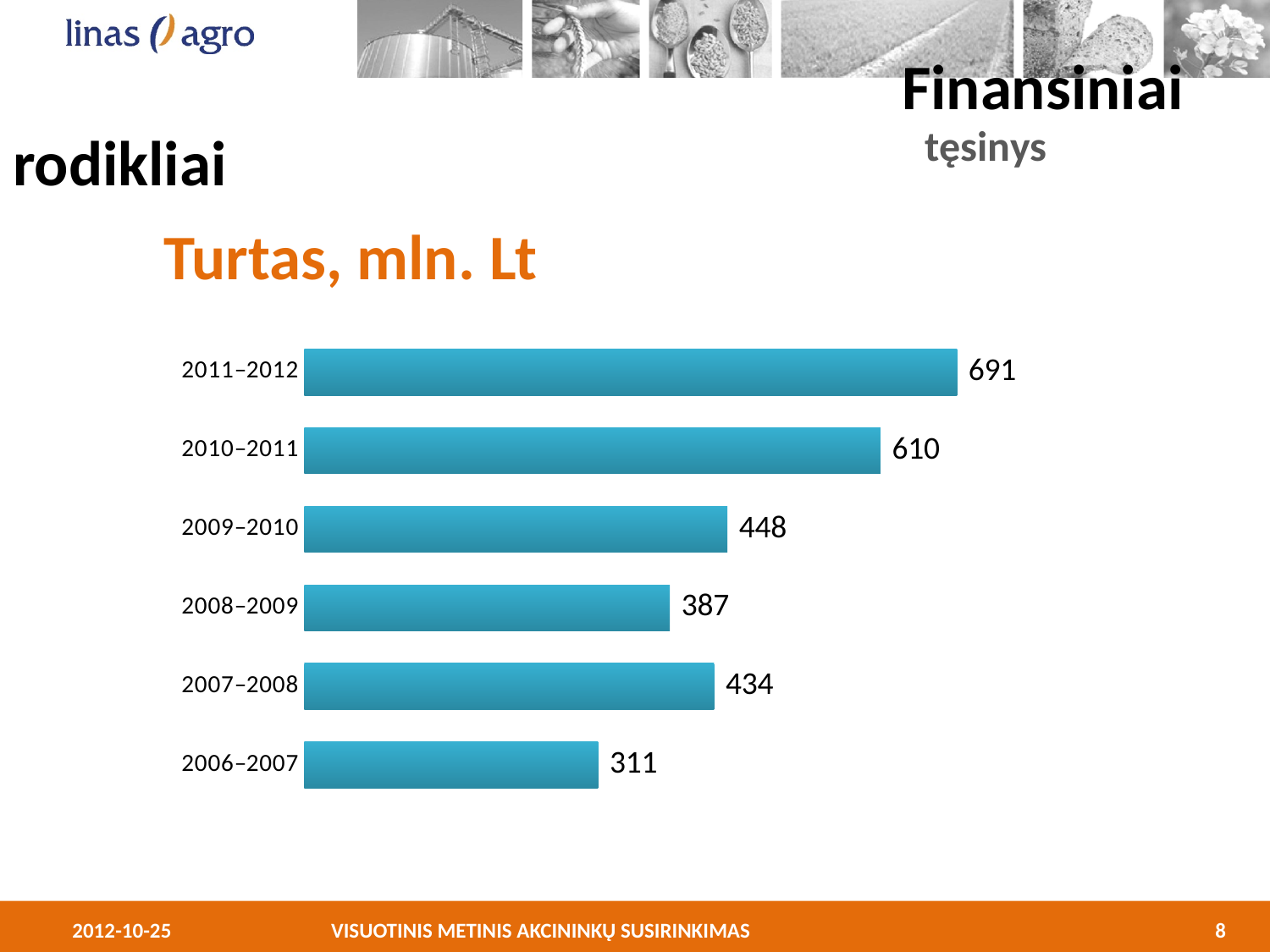
What is the title of the chart on the slide? Turtas, mln. Lt Which is larger in the Turtas, mln. Lt chart: the value for 2007–2008 or 2008–2009? 2007–2008 What is the value for 2008–2009 in the Turtas, mln. Lt chart? 387 What colour are the bars in the Turtas, mln. Lt chart? blue What is the value for 2011–2012 in the Turtas, mln. Lt chart? 691 What is the difference between the values for 2011–2012 and 2010–2011 in the Turtas, mln. Lt chart? 81 Which period has the lowest value in the Turtas, mln. Lt chart? 2006–2007 What kind of chart is the Turtas, mln. Lt chart? bar chart What is the value for 2006–2007 in the Turtas, mln. Lt chart? 311 What is the difference between the values for 2009–2010 and 2008–2009 in the Turtas, mln. Lt chart? 61 Which period has the highest value in the Turtas, mln. Lt chart? 2011–2012 How many periods are shown in the Turtas, mln. Lt chart? 6